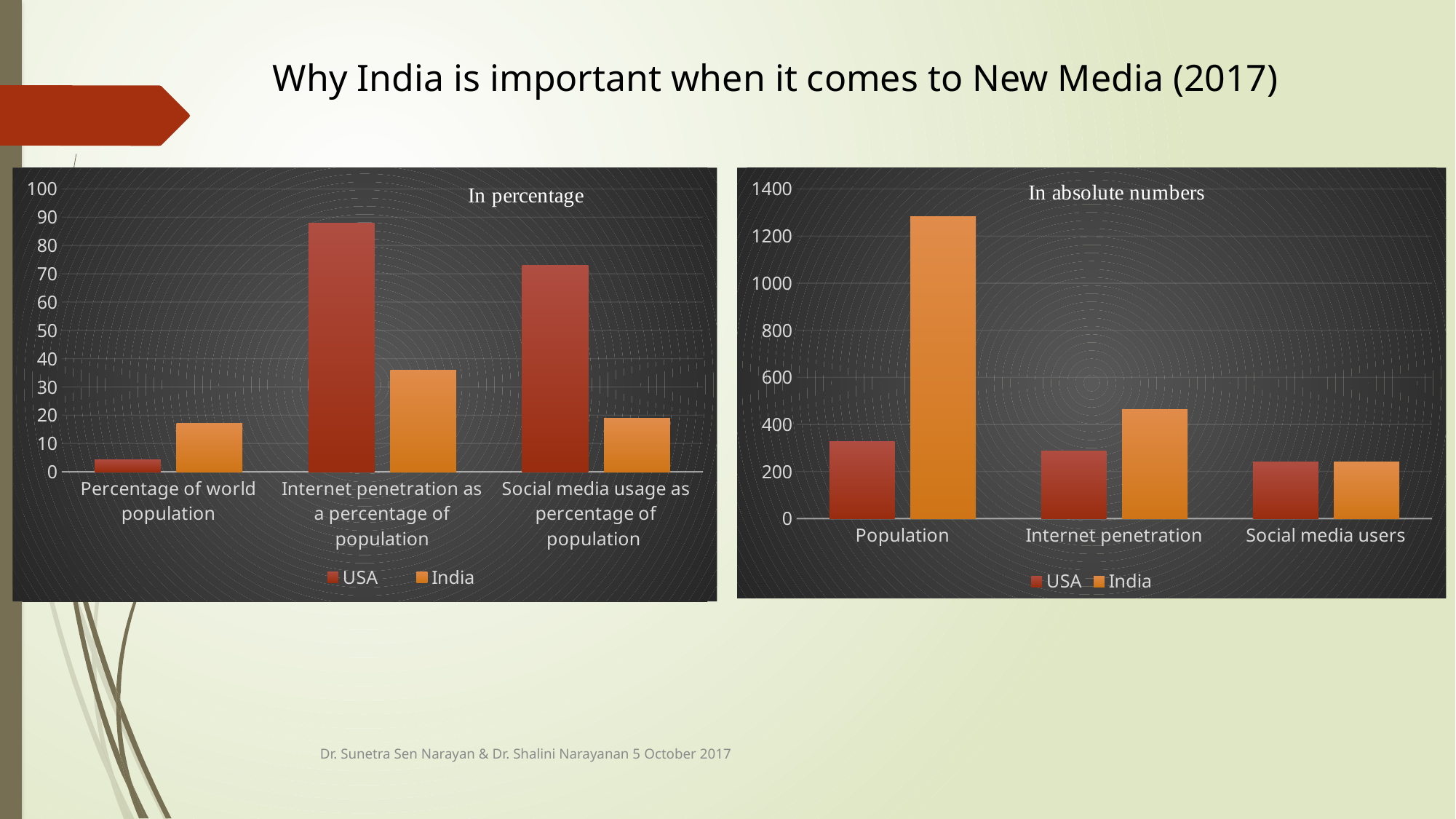
In the 'In percentage' chart, is the USA value for Internet penetration as a percentage of population greater or less than 80? greater In the 'In absolute numbers' chart, which is larger for Population, USA or India? India In the 'In absolute numbers' chart, is the India value for Internet penetration greater or less than 400? greater In the 'In percentage' chart, which category has the lowest value for USA? Percentage of world population Which series is shown in orange in both charts? India How many series does the legend of the 'In absolute numbers' chart list? 2 What kind of chart is the 'In percentage' chart on the left? Bar chart In the 'In percentage' chart, which category has the highest value for USA? Internet penetration as a percentage of population In the 'In absolute numbers' chart, is the India value for Population greater or less than 1200? greater How many categories are shown on the x axis of the 'In percentage' chart? 3 In the 'In percentage' chart, which is larger for Internet penetration as a percentage of population, USA or India? USA In the 'In absolute numbers' chart, which category has the highest value for India? Population